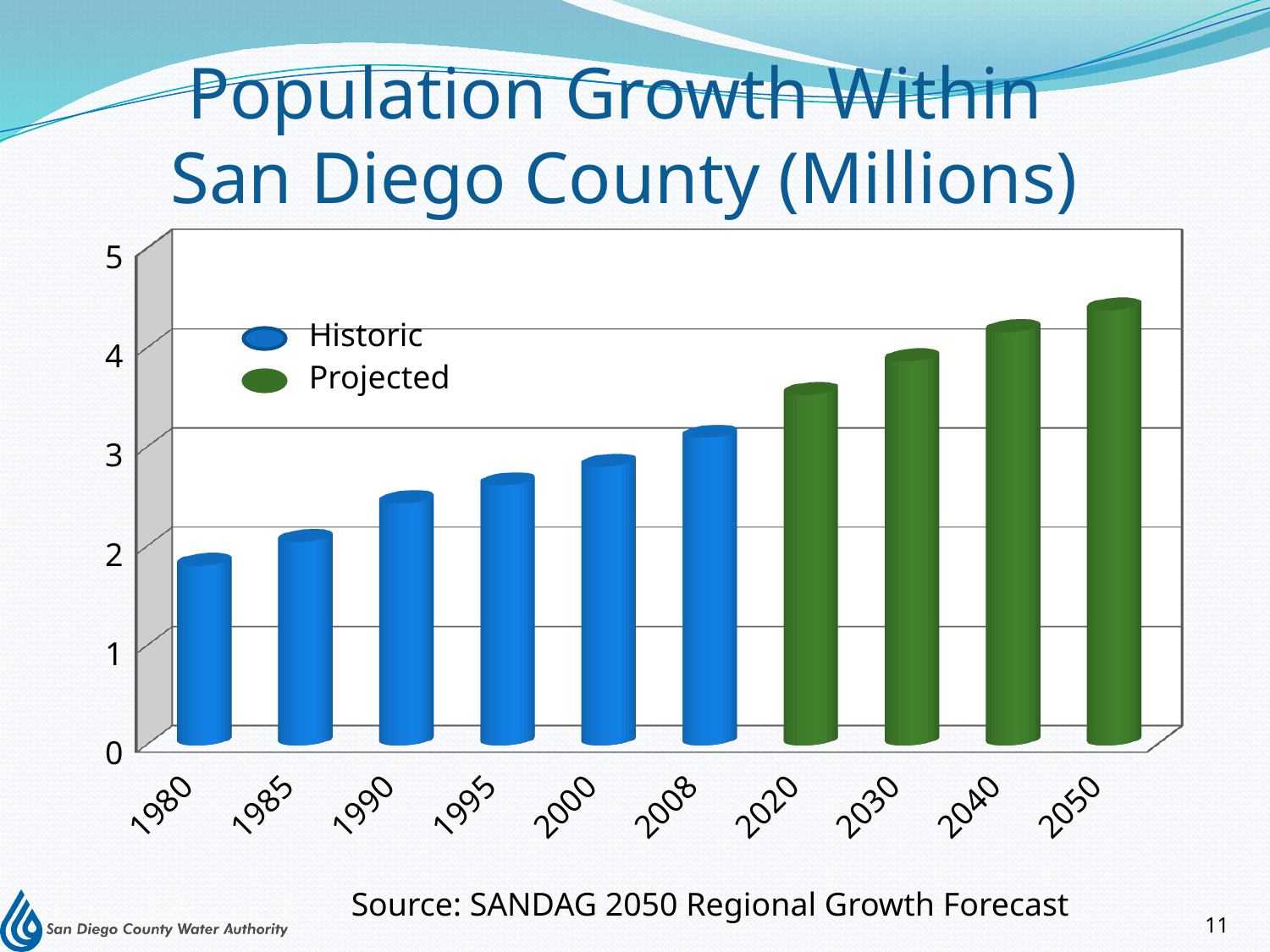
Is the value for 1995 greater or less than 3? less Is the value for 1990 greater or less than 2? greater How many series does the legend list? 2 Do the population values rise or fall from 1980 to 2050? rise Which year has the highest population value in the chart? 2050 How many years are shown along the x axis of the chart? 10 Is the value for 1980 greater or less than 2? less Which is larger, the value for 2008 or the value for 2020? 2020 What kind of chart is shown on the slide? bar chart Which year has the lowest population value in the chart? 1980